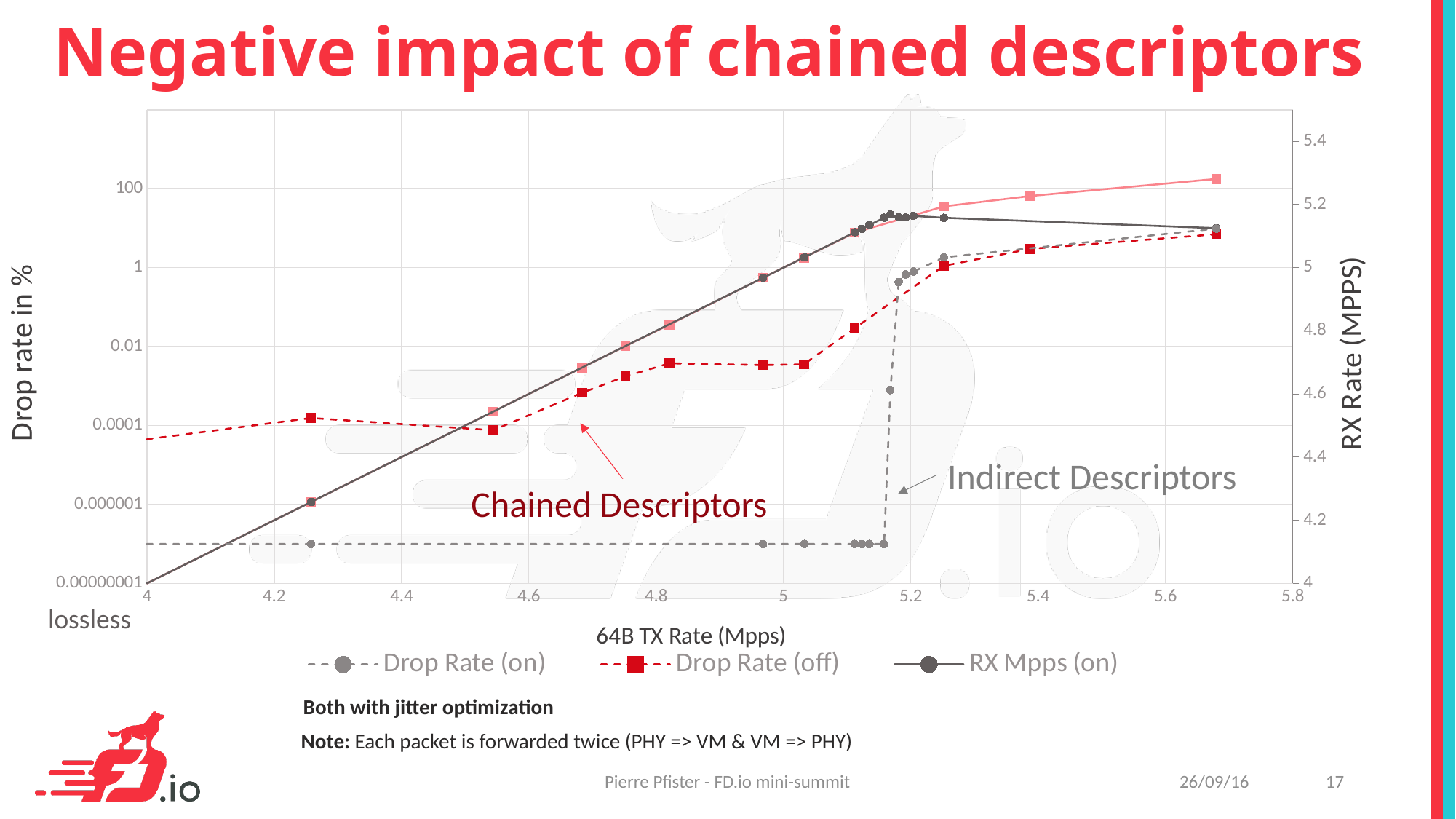
What kind of chart is shown on the slide? line chart Does the RX Mpps (on) series rise or fall between a TX rate of 5.2 and 5.68? fall Is the Drop Rate (on) value at a TX rate of 5.0 greater or less than 0.0001 on the left axis? less What is the title of the x axis of the chart? 64B TX Rate (Mpps) At a TX rate of 5.0, which series has the higher drop rate, Drop Rate (on) or Drop Rate (off)? Drop Rate (off) Is the Drop Rate (off) value at a TX rate of 4.26 greater or less than 0.01 on the left axis? less Does the Drop Rate (off) series generally rise or fall as the TX rate increases from 4.6 to 5.6? rise What are the three series named in the chart legend? Drop Rate (on), Drop Rate (off), RX Mpps (on) Is the RX Mpps (on) value at a TX rate of 5.68 greater or less than 5 on the right axis? greater Does the RX Mpps (on) series rise or fall as the TX rate increases from 4 to 5.1? rise How many series does the chart legend list? 3